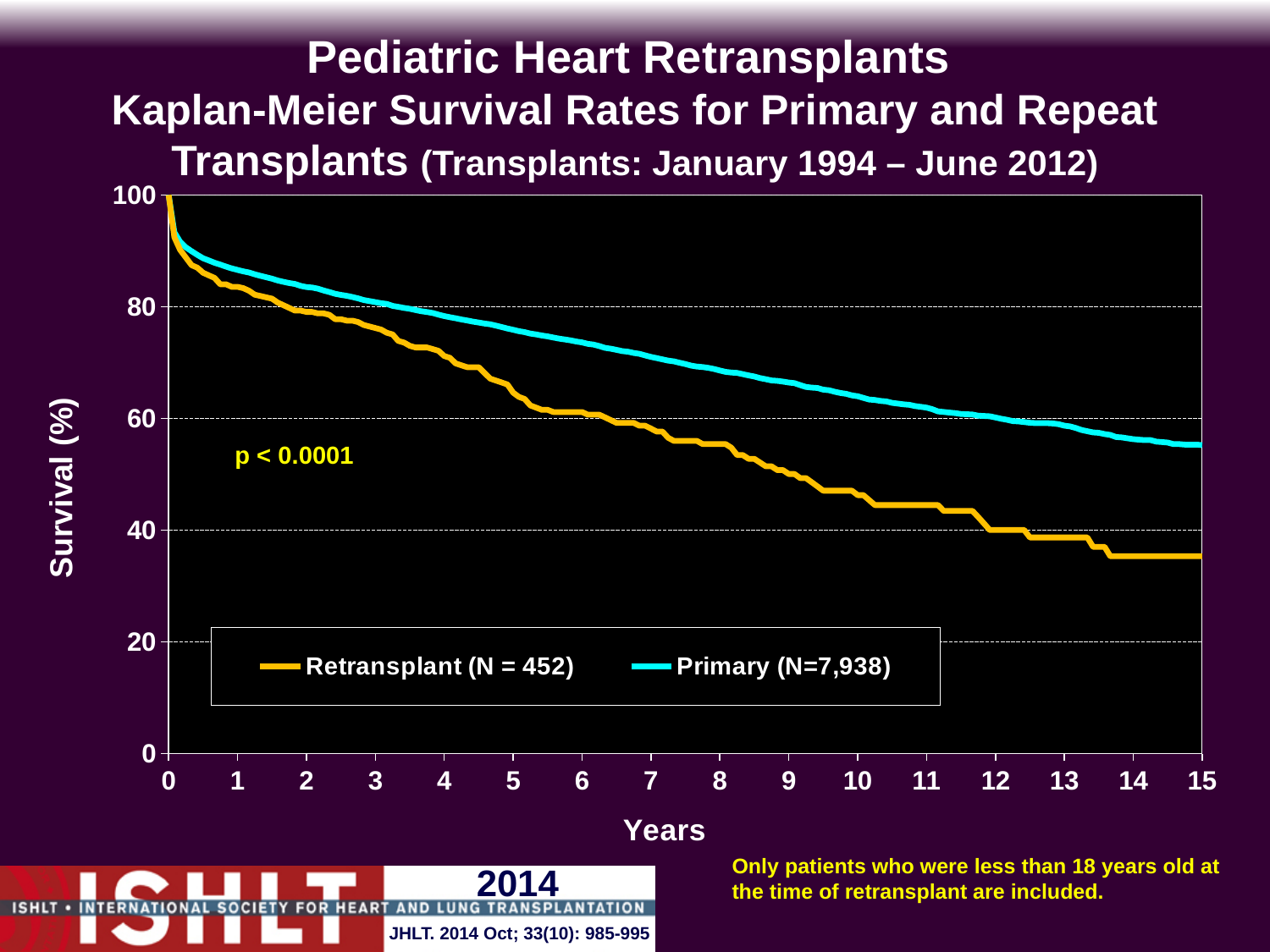
Is the survival value for Retransplant at 10 years greater or less than 40? greater Is the survival value for Primary at 10 years greater or less than 60? greater How many series does the legend list? 2 Is the survival value for Retransplant at 15 years greater or less than 40? less What kind of chart is shown on the slide? line chart Do the survival values rise or fall as the years increase along the x axis? fall What p-value is printed on the chart? p < 0.0001 Which series has the higher survival at 10 years, Retransplant or Primary? Primary What is the N shown in the legend for the Retransplant series? 452